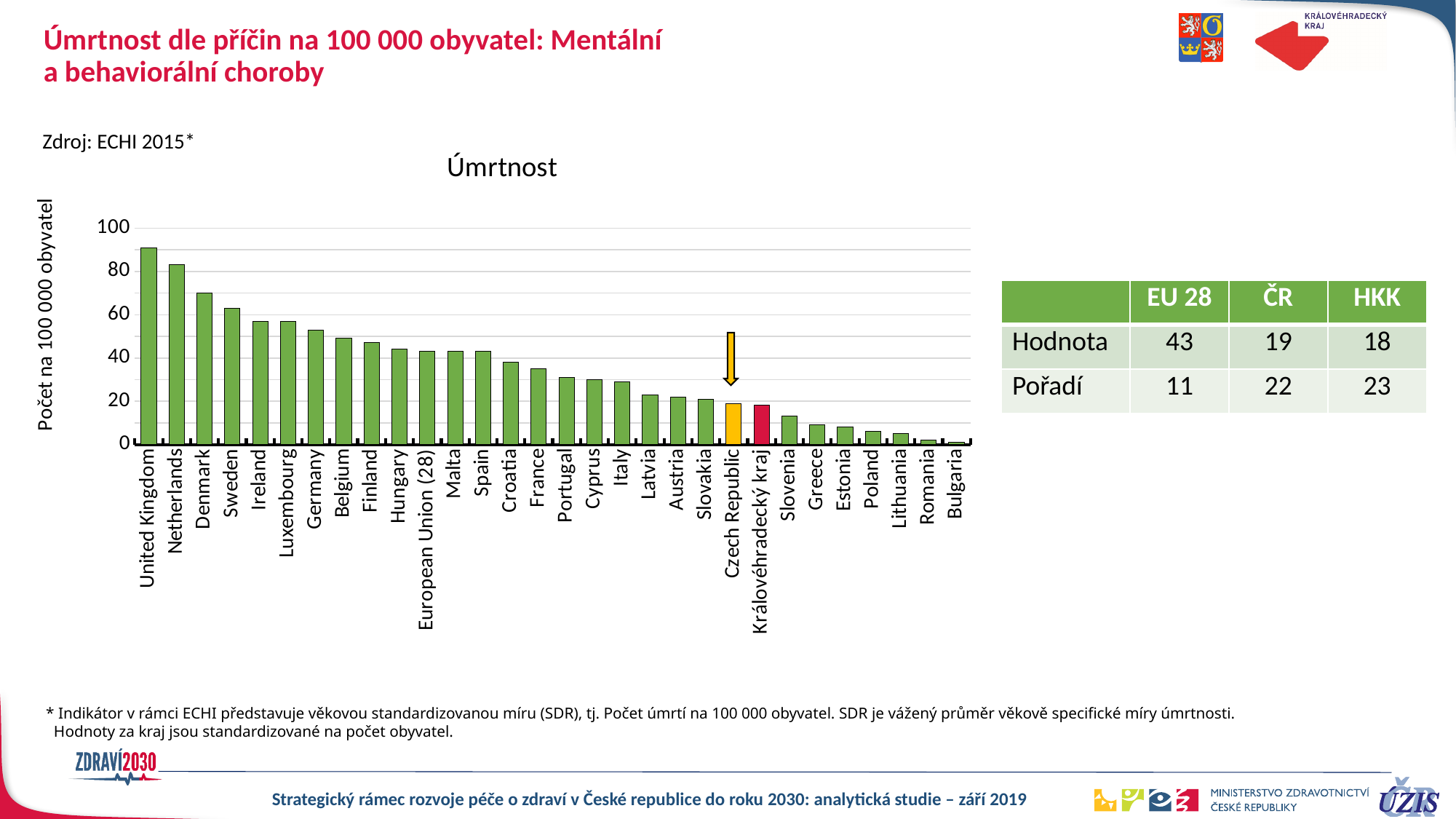
According to the table, what is the value (Hodnota) for HKK? 18 According to the table, what is the value (Hodnota) for EU 28? 43 What is the difference between the EU 28 value and the ČR value in the table? 24 What type of chart is shown on the slide? bar chart According to the table, what is the rank (Pořadí) of ČR? 22 Which is larger, the value for Czech Republic or for Královéhradecký kraj? Czech Republic Do the bar values rise or fall from left to right along the x axis? fall Which category has the highest value in the chart? United Kingdom What is the title of the chart? Úmrtnost How many bars (categories) are plotted in the chart? 30 Which category has the lowest value in the chart? Bulgaria Is the value for Denmark greater or less than 60? greater